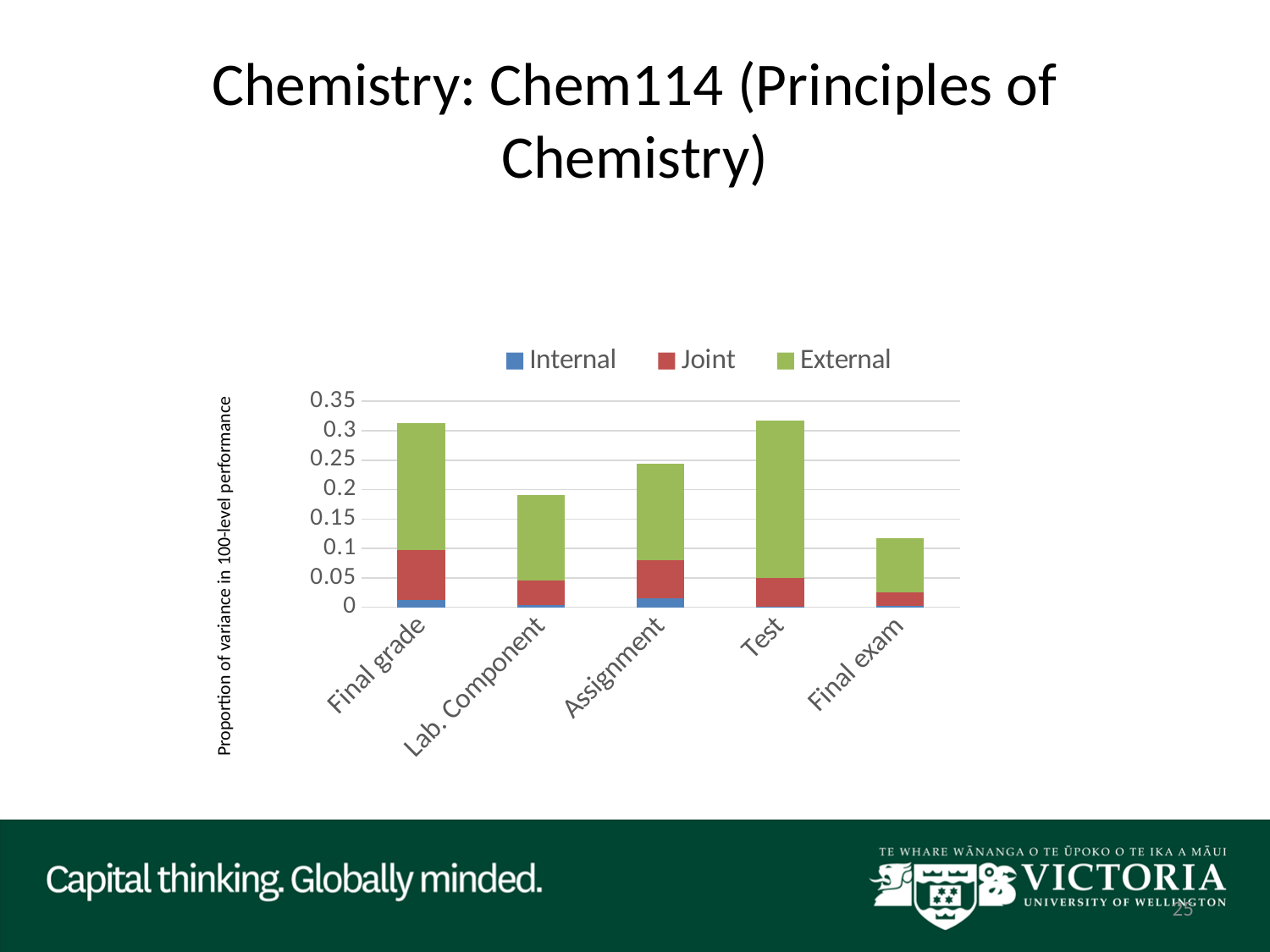
How many series does the chart's legend list? 3 Is the total stacked value for Test greater or less than 0.3? greater Is the total stacked value for Assignment greater or less than 0.2? greater What kind of chart is shown on the slide? Stacked bar chart What is the title of the chart's vertical axis? Proportion of variance in 100-level performance Which category has the lowest total stacked bar? Final exam How many categories are shown on the x axis of the chart? 5 Is the total stacked value for Final exam greater or less than 0.15? less What are the three series named in the chart's legend? Internal, Joint, External Which has the larger total stacked bar, Assignment or Lab. Component? Assignment Which has the larger total stacked bar, Lab. Component or Final exam? Lab. Component